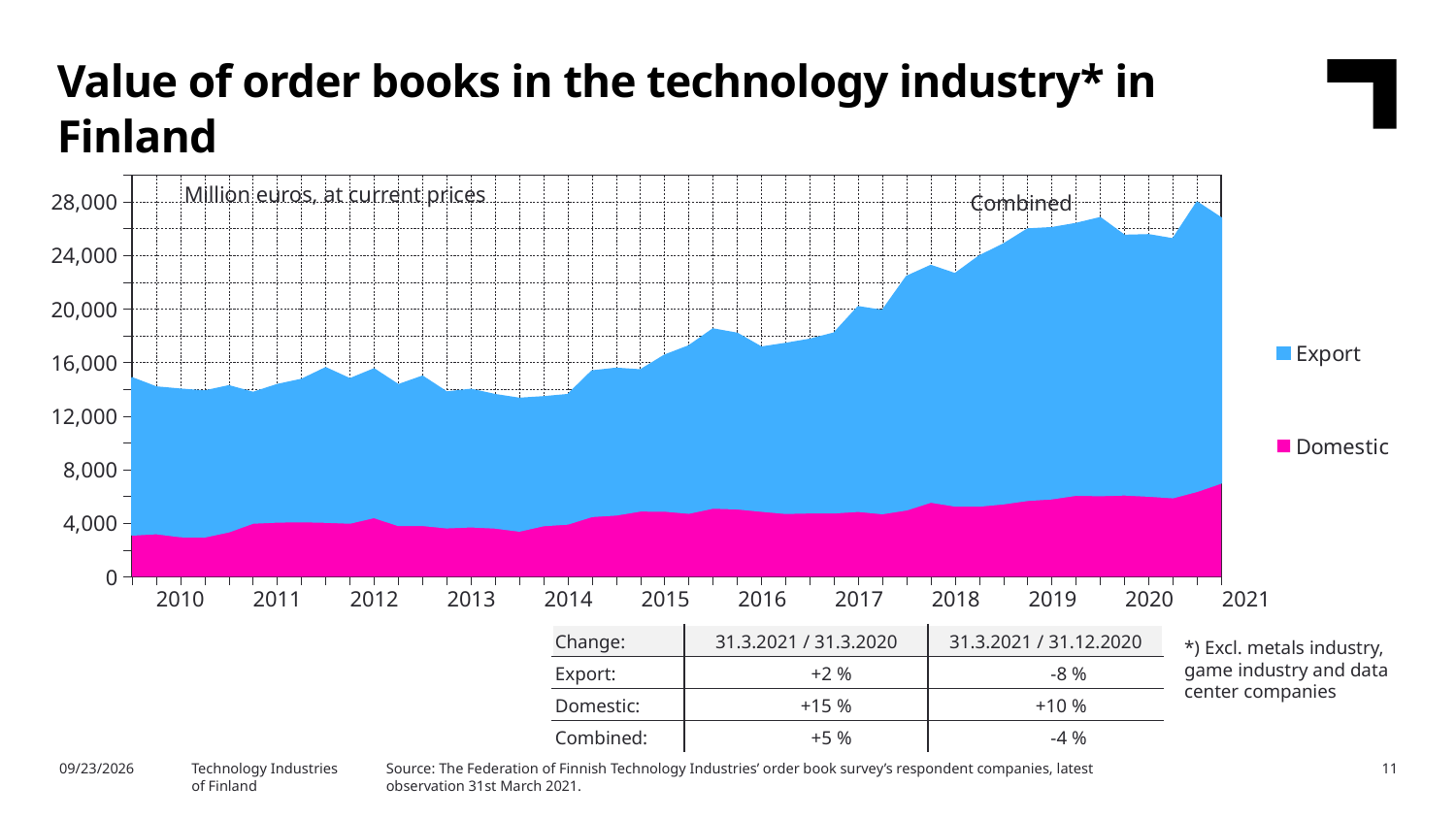
Which two series are listed in the chart legend? Export and Domestic What unit is stated for the values in the chart? Million euros, at current prices Is the Combined value during 2013 greater or less than 16,000? less How many series does the legend list? 2 At the end of the series in 2021, which is larger, the Export value or the Domestic value? Export Is the Combined value at the end of the series in 2021 greater or less than 24,000? greater Is the Combined value at the start of 2010 greater or less than 16,000? less What kind of chart is shown on the slide? Stacked area chart How many year labels are shown on the x axis? 12 Does the Domestic value rise or fall overall from 2010 to 2021? rise